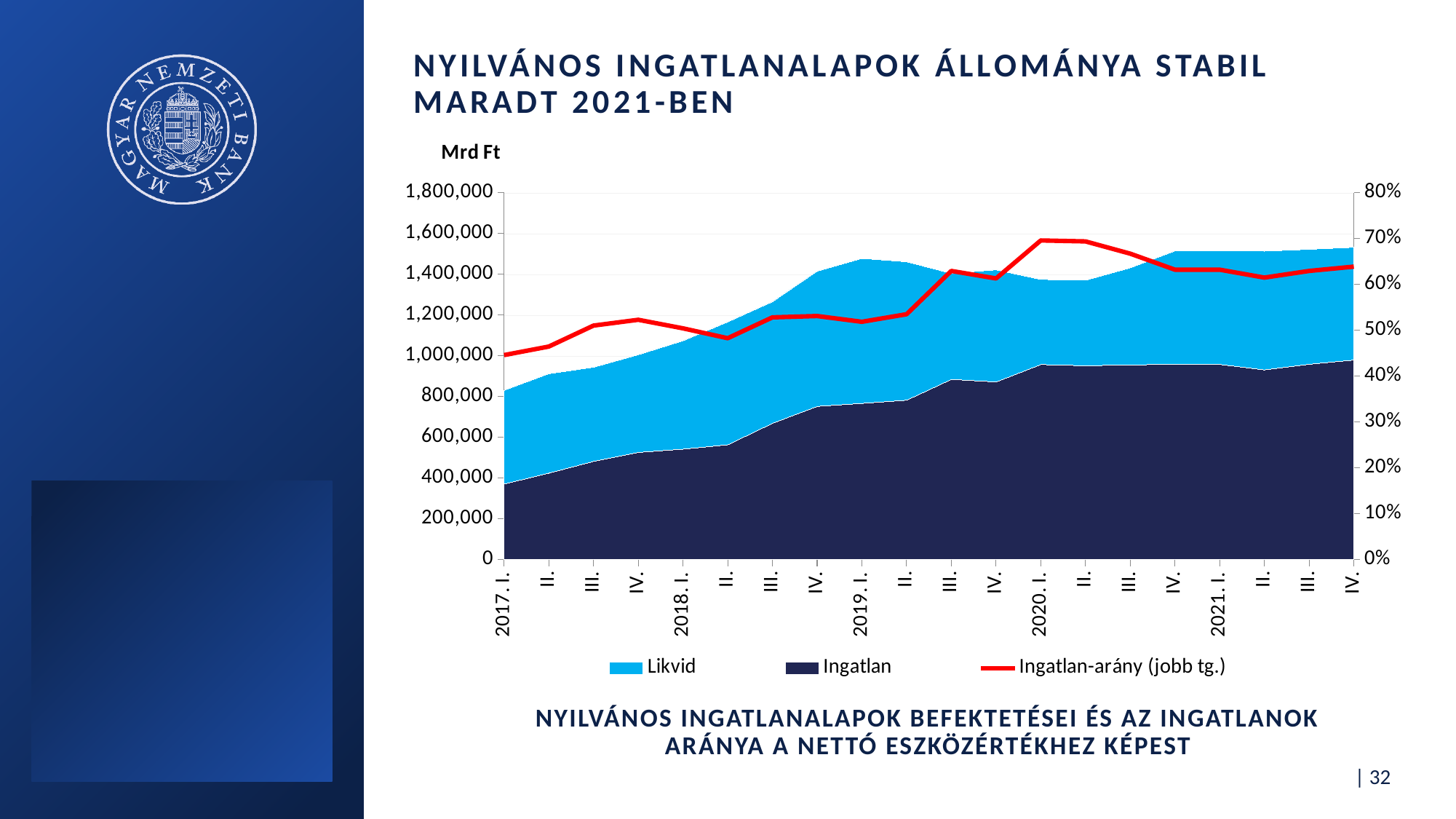
Does the Ingatlan series rise or fall from 2017. I. to 2021. IV.? rise How many quarterly points are plotted along the x axis? 20 Is the Ingatlan-arány value for 2017. I. greater or less than 50%? less Is the Ingatlan value for 2017. I. greater or less than 400,000? less Is the Ingatlan value for 2021. IV. greater or less than 800,000? greater What unit is shown above the left axis? Mrd Ft How many series does the legend list? 3 What kind of chart is shown on the slide? Stacked area chart with a line In which quarter is the Ingatlan-arány lowest? 2017. I. Which series is plotted on the right-hand axis according to the legend? Ingatlan-arány (jobb tg.)